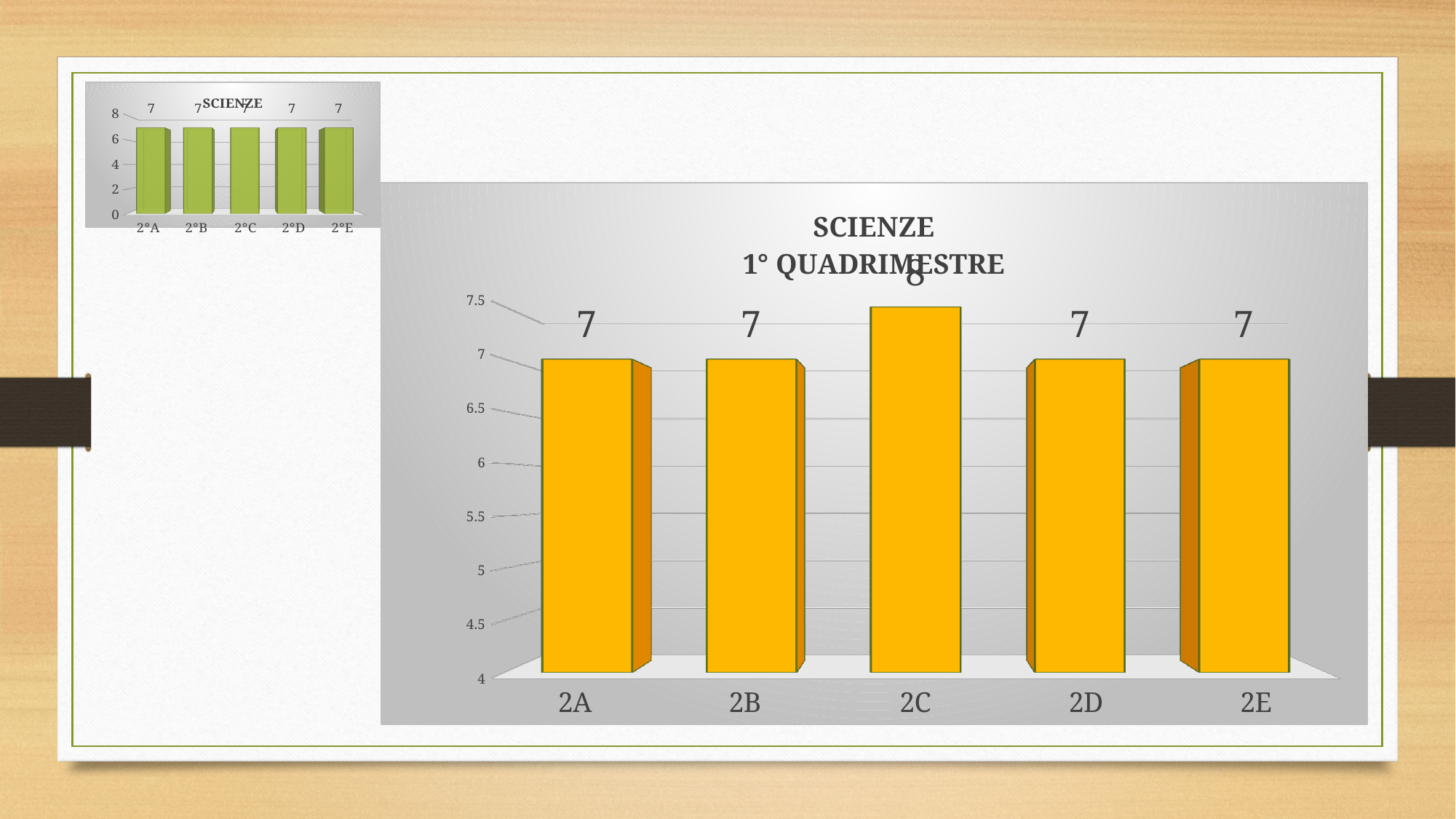
What kind of chart is the large chart titled 'SCIENZE 1° QUADRIMESTRE'? bar chart What colour are the bars in the large chart titled 'SCIENZE 1° QUADRIMESTRE'? orange In the chart titled 'SCIENZE 1° QUADRIMESTRE', which category has the highest value? 2C In the small chart titled 'SCIENZE' at the top left, what is the difference between the values for 2°A and 2°E? 0 In the chart titled 'SCIENZE 1° QUADRIMESTRE', what is the difference between the values for 2C and 2E? 1 In the small chart titled 'SCIENZE' at the top left, how many bars are shown? 5 In the chart titled 'SCIENZE 1° QUADRIMESTRE', is the value for 2B greater or less than 7.5? less In the chart titled 'SCIENZE 1° QUADRIMESTRE', how many categories are shown on the x axis? 5 In the chart titled 'SCIENZE 1° QUADRIMESTRE', what is the value for 2A? 7 In the chart titled 'SCIENZE 1° QUADRIMESTRE', what is the value for 2C? 8 In the chart titled 'SCIENZE 1° QUADRIMESTRE', is the value for 2C larger than the value for 2D? yes In the small chart titled 'SCIENZE' at the top left, what is the value for 2°B? 7